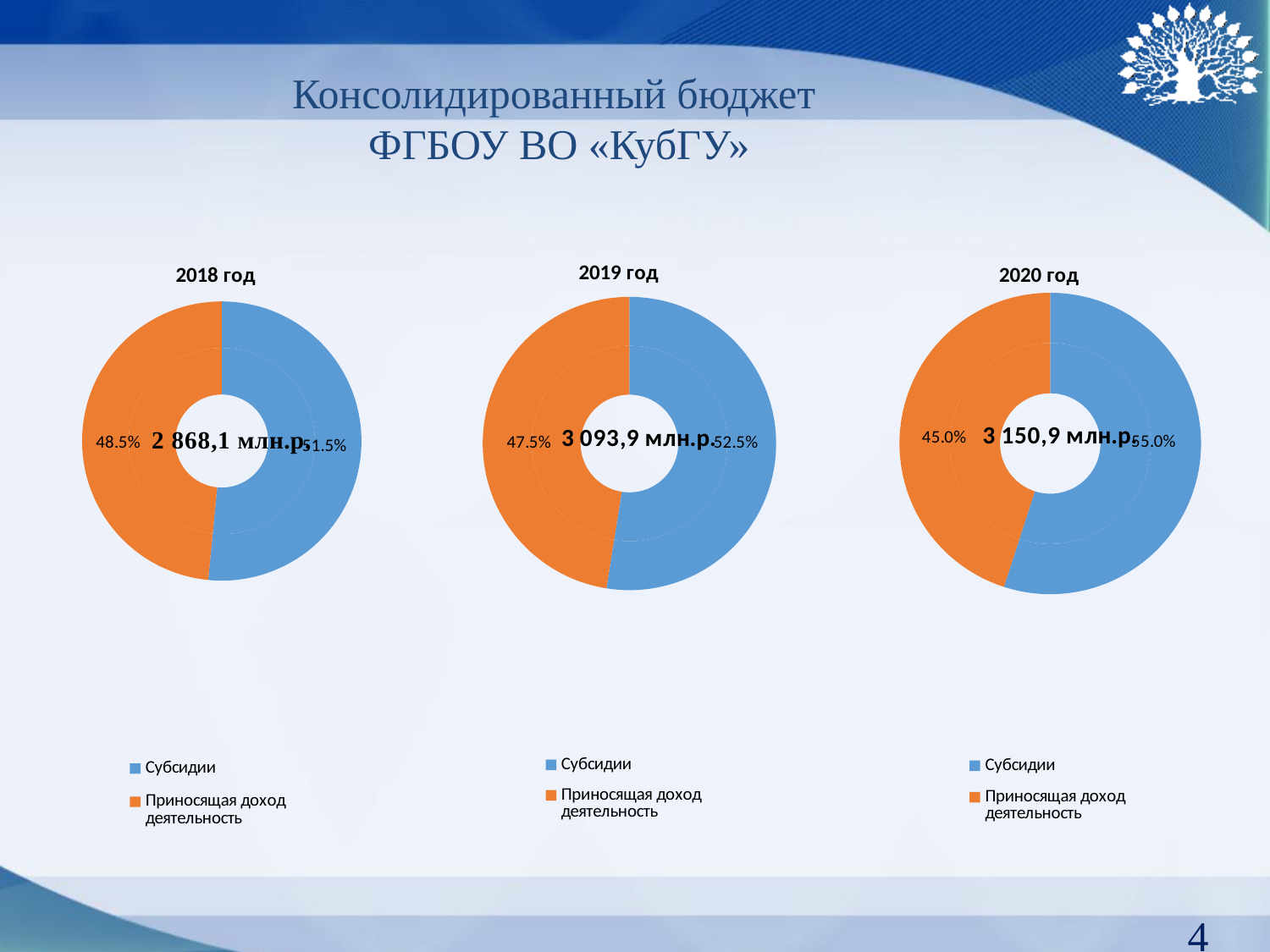
In the 2019 год chart, what share does Субсидии have? 52.5% Which is larger in the 2018 год chart: the share of Субсидии or the share of Приносящая доход деятельность? Субсидии In the 2020 год chart, which category has the largest share? Субсидии What kind of chart is the 2018 год chart? Doughnut chart What total value is shown in the centre of the 2020 год chart? 3 150,9 млн.р. In the 2018 год chart, what share does Приносящая доход деятельность have? 48.5% In the 2020 год chart, what is the difference between the shares of Субсидии and Приносящая доход деятельность? 10.0% In the 2018 год chart, what share does Субсидии have? 51.5% How many categories does the legend of the 2019 год chart list? 2 In the 2019 год chart, which category has the smallest share? Приносящая доход деятельность What total value is shown in the centre of the 2019 год chart? 3 093,9 млн.р. In the 2020 год chart, what share does Приносящая доход деятельность have? 45.0%